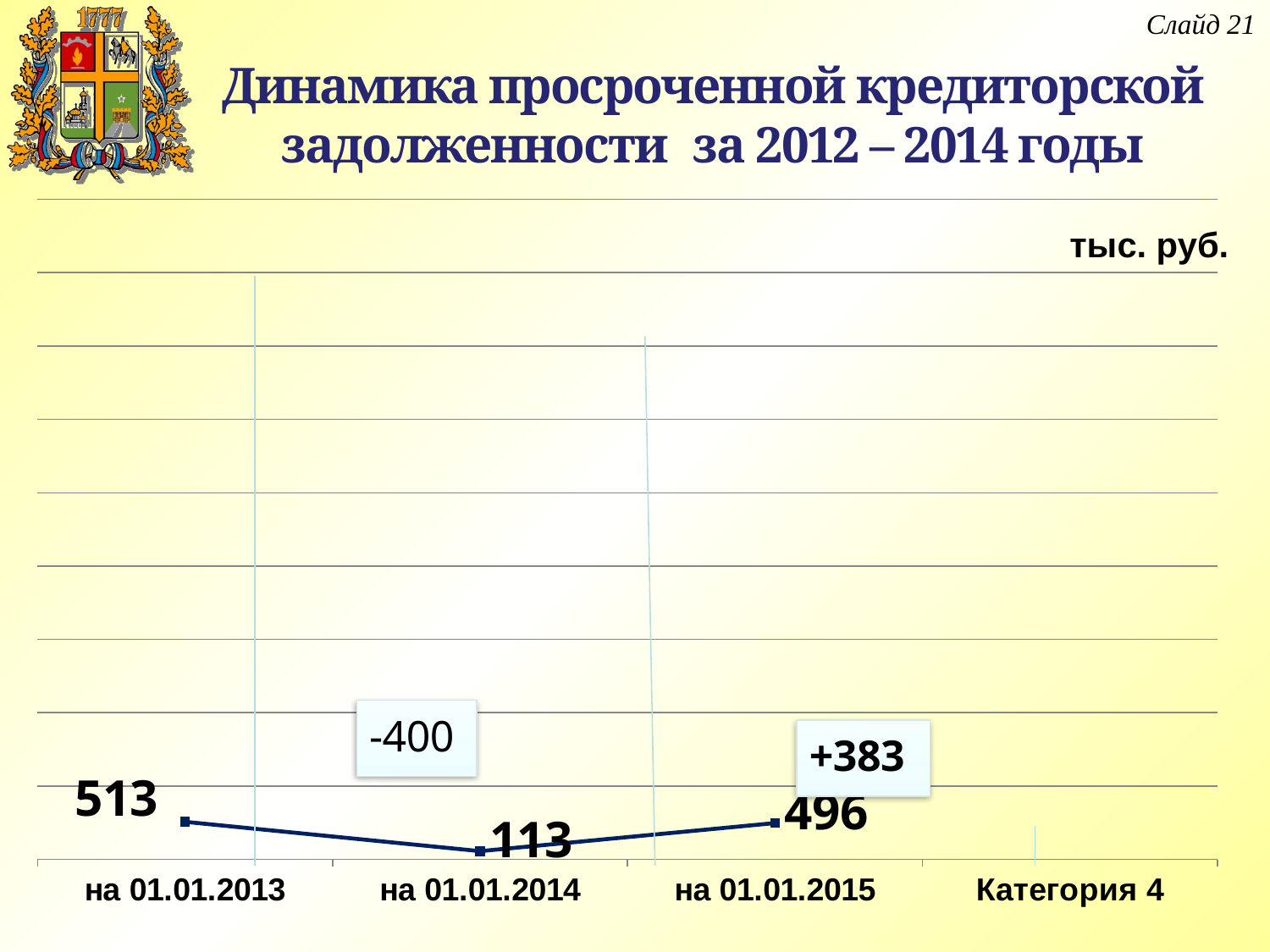
What kind of chart is shown on the slide? line chart What is the value for на 01.01.2015? 496 How many data points are plotted on the line? 3 What is the value for на 01.01.2013? 513 What is the value for на 01.01.2014? 113 Does the value rise or fall from на 01.01.2014 to на 01.01.2015? rise What is the difference between the values for на 01.01.2015 and на 01.01.2014? 383 Which date has the lowest value? на 01.01.2014 What is the difference between the values for на 01.01.2013 and на 01.01.2014? 400 Which date has the highest value? на 01.01.2013 What unit of measurement is indicated above the chart? тыс. руб. Which is larger, the value for на 01.01.2013 or the value for на 01.01.2015? на 01.01.2013